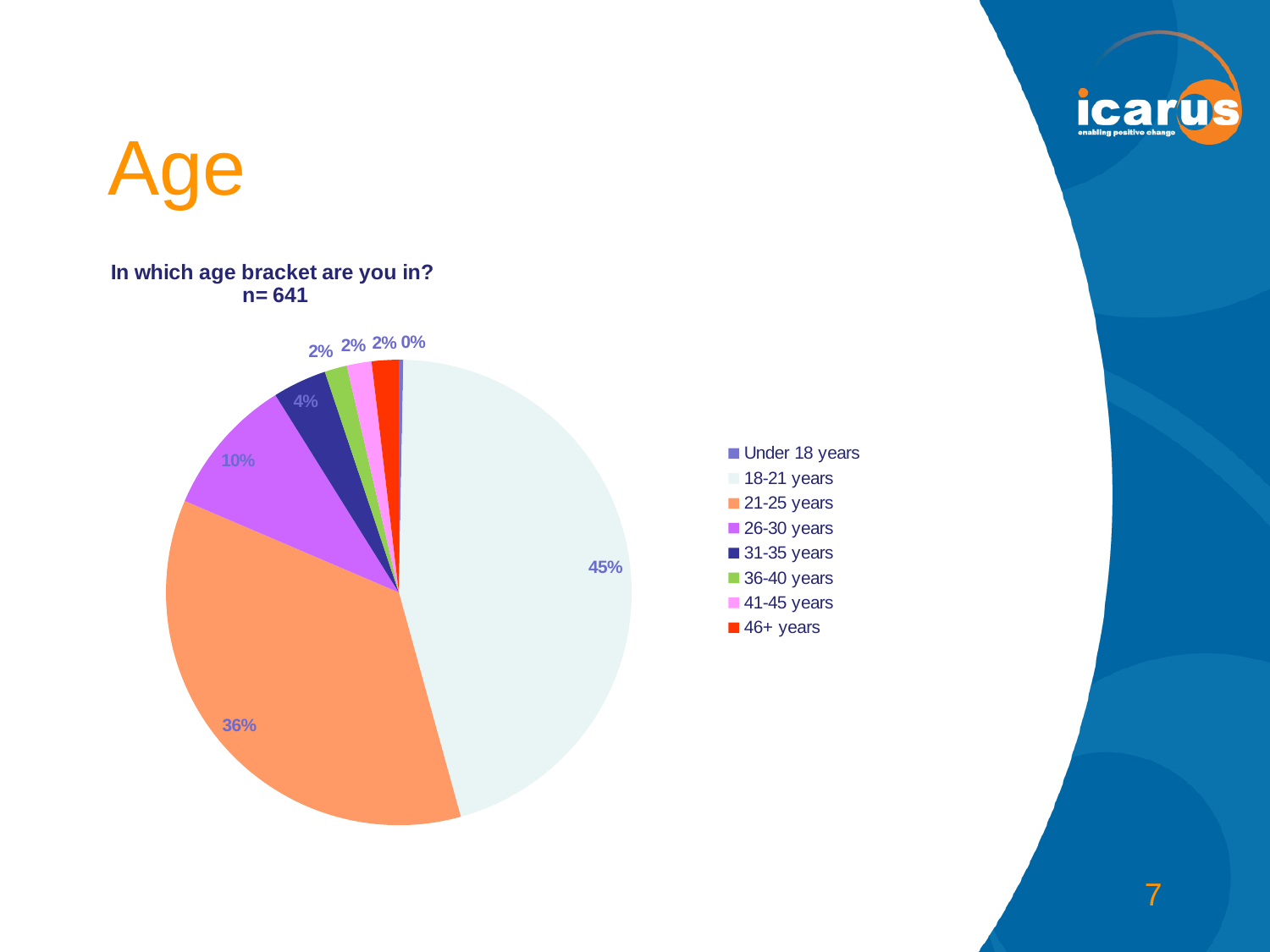
What kind of chart is shown on the slide? Pie chart How many age brackets does the legend list? 8 What share of respondents are in the 31-35 years bracket? 4% Which is larger, the 26-30 years slice or the 31-35 years slice? 26-30 years What share of respondents are Under 18 years? 0% What share of respondents are in the 21-25 years bracket? 36% Which age bracket has the smallest share of the pie? Under 18 years What is the difference in percentage points between the 18-21 years and 21-25 years slices? 9 What is the sample size (n) stated in the chart title? 641 What share of respondents are in the 18-21 years bracket? 45% What share of respondents are in the 26-30 years bracket? 10% Which age bracket has the largest share of the pie? 18-21 years